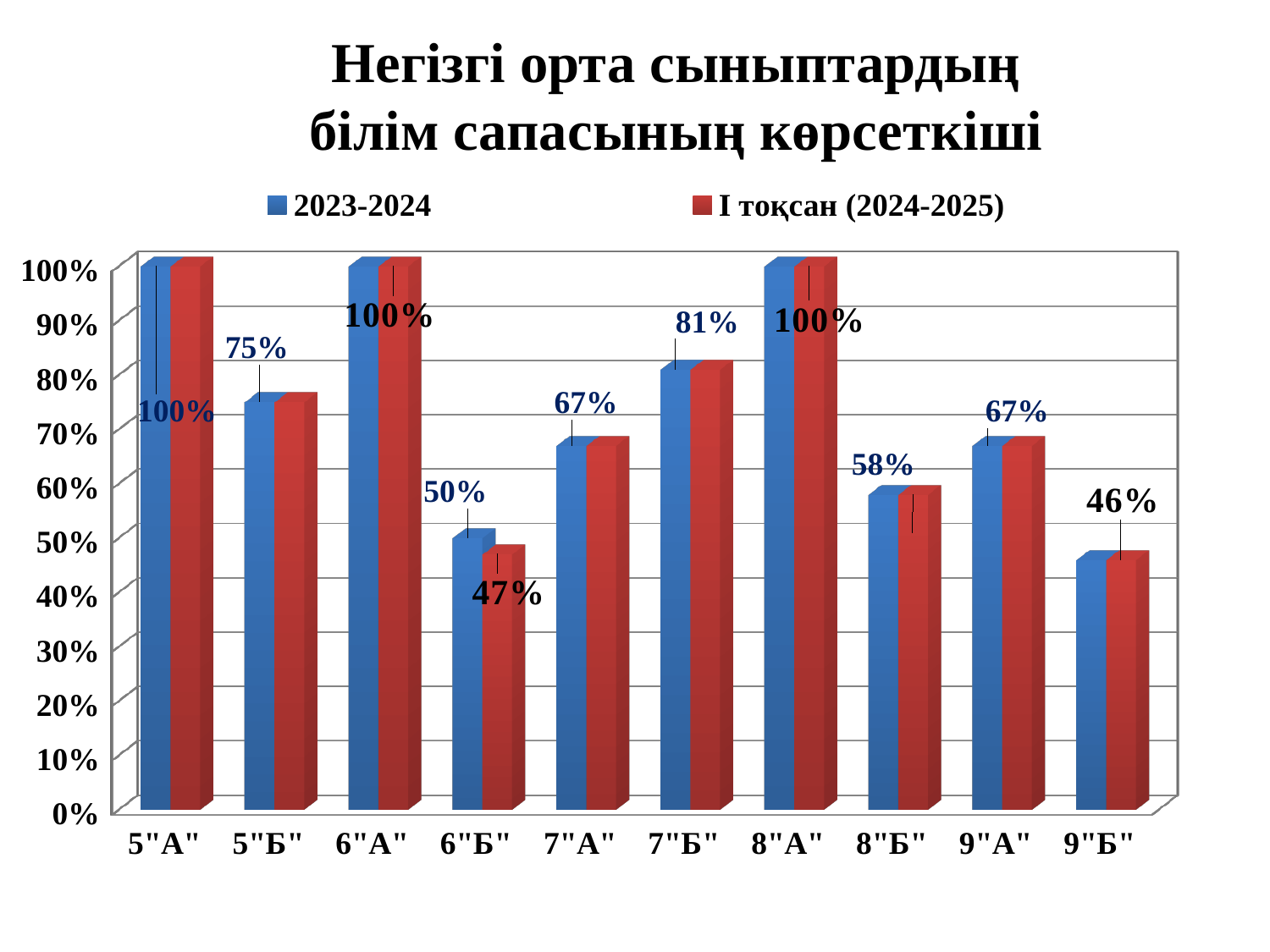
What is the value for 8"Б" in the 2023-2024 series? 58% Is the 2023-2024 value for 9"Б" greater or less than 50%? less What is the value for 6"Б" in the I тоқсан (2024-2025) series? 47% How many classes (categories) are shown on the x axis? 10 Which has the larger 2023-2024 value, 5"Б" or 7"Б"? 7"Б" What kind of chart is shown on the slide? bar chart What is the value for 5"Б" in the 2023-2024 series? 75% What is the difference between the 2023-2024 value and the I тоқсан (2024-2025) value for 6"Б"? 3% What are the two legend entries of the chart? 2023-2024 and I тоқсан (2024-2025) What is the value for 7"Б" in the 2023-2024 series? 81% What is the value for 9"Б" in the I тоқсан (2024-2025) series? 46% How many series does the legend list? 2